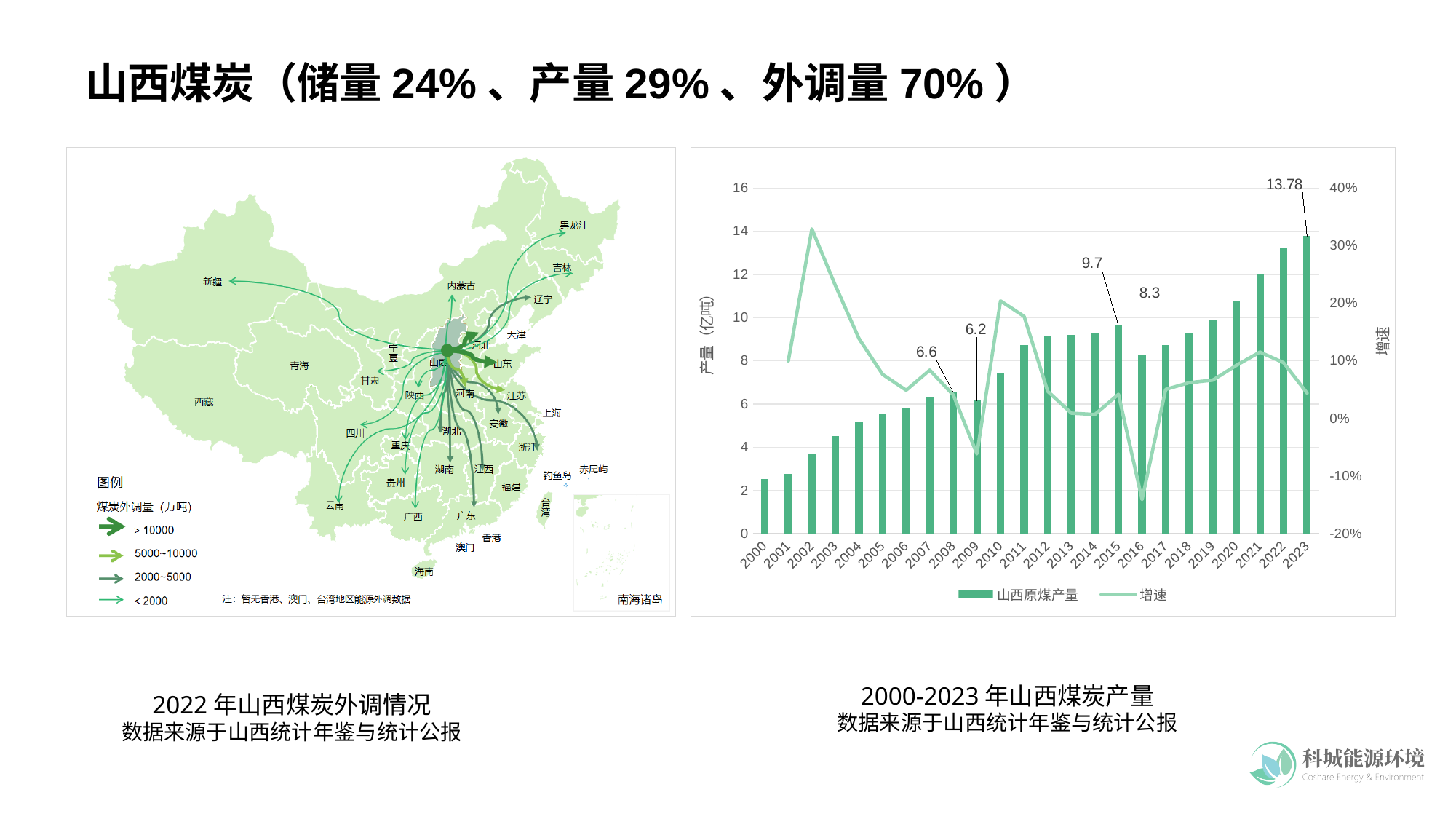
In the 2000-2023年山西煤炭产量 chart, how many years are shown on the x axis? 24 In the 2000-2023年山西煤炭产量 chart, which year has a higher labelled production value, 2008 or 2009? 2008 In the 2000-2023年山西煤炭产量 chart, does the 山西原煤产量 series generally rise or fall from 2000 to 2023? rise In the 2000-2023年山西煤炭产量 chart, is the production bar for 2021 greater or less than 10? greater In the 2000-2023年山西煤炭产量 chart, how many series does the legend list? 2 In the 2000-2023年山西煤炭产量 chart, what is the labelled coal production value for 2009? 6.2 In the 2000-2023年山西煤炭产量 chart, what is the labelled coal production value for 2016? 8.3 In the 2000-2023年山西煤炭产量 chart, which year has the tallest production bar? 2023 In the 2000-2023年山西煤炭产量 chart, which year has the shortest production bar? 2000 In the 2000-2023年山西煤炭产量 chart, what is the labelled coal production value for 2015? 9.7 In the 2000-2023年山西煤炭产量 chart, what is the difference between the labelled values for 2015 and 2016? 1.4 In the 2000-2023年山西煤炭产量 chart, what is the labelled coal production value for 2023? 13.78